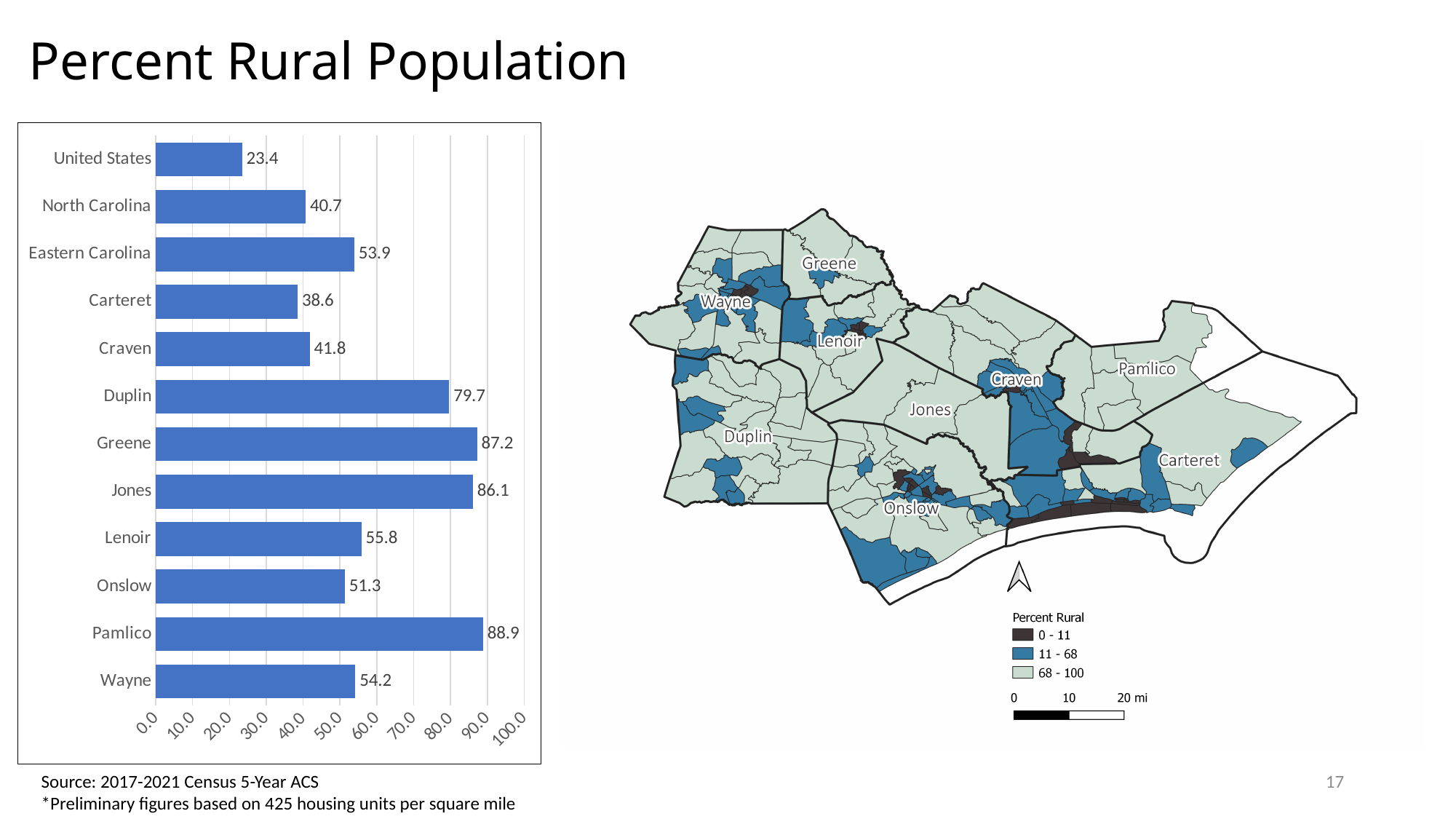
Which category has the highest value in the bar chart? Pamlico Which has a larger value in the bar chart, Duplin or Lenoir? Duplin What is the difference between the values for North Carolina and the United States in the bar chart? 17.3 Which has a larger value in the bar chart, Carteret or Craven? Craven How many categories are shown in the bar chart? 12 What is the difference between the values for Greene and Jones in the bar chart? 1.1 What is the value shown for the United States in the bar chart? 23.4 What is the value shown for Eastern Carolina in the bar chart? 53.9 Which category has the lowest value in the bar chart? United States What kind of chart is shown on the left of the slide? Bar chart What is the percent rural population value for Pamlico in the bar chart? 88.9 What is the value shown for Onslow in the bar chart? 51.3